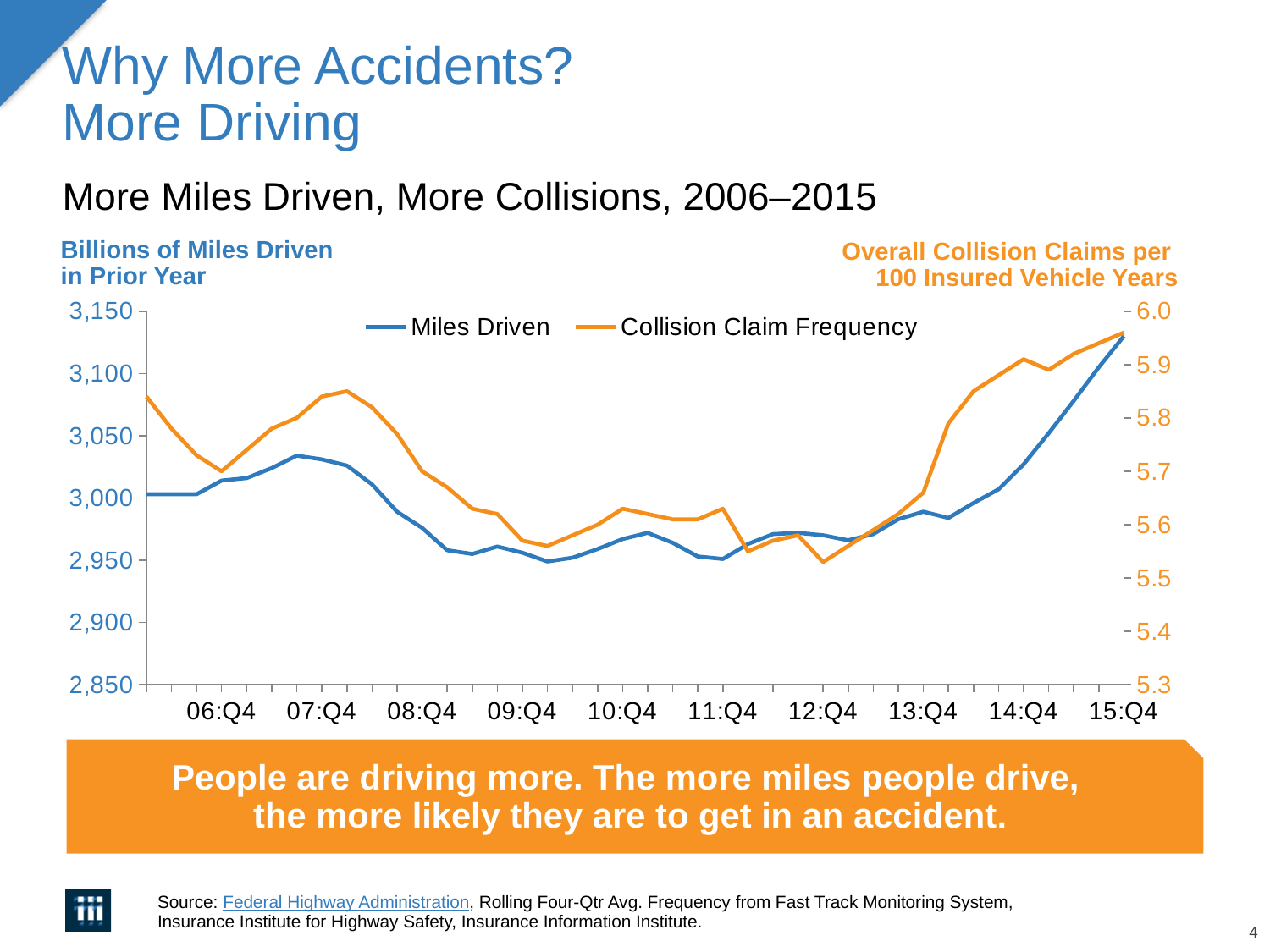
What kind of chart is shown on the slide? line chart At which labelled quarter does the Collision Claim Frequency series reach its lowest value? 12:Q4 Is the Miles Driven value at 12:Q4 greater or less than 3,000? less What are the two series named in the legend? Miles Driven and Collision Claim Frequency Does the Miles Driven series rise or fall between 13:Q4 and 15:Q4? rise Is the Miles Driven value at 15:Q4 greater or less than 3,100? greater Is the Collision Claim Frequency value at 07:Q4 greater or less than 5.8? greater What is the title of the chart? More Miles Driven, More Collisions, 2006–2015 How many series does the legend list? 2 At which labelled quarter does the Miles Driven series reach its highest value? 15:Q4 Does the Collision Claim Frequency series rise or fall between 07:Q4 and 09:Q4? fall